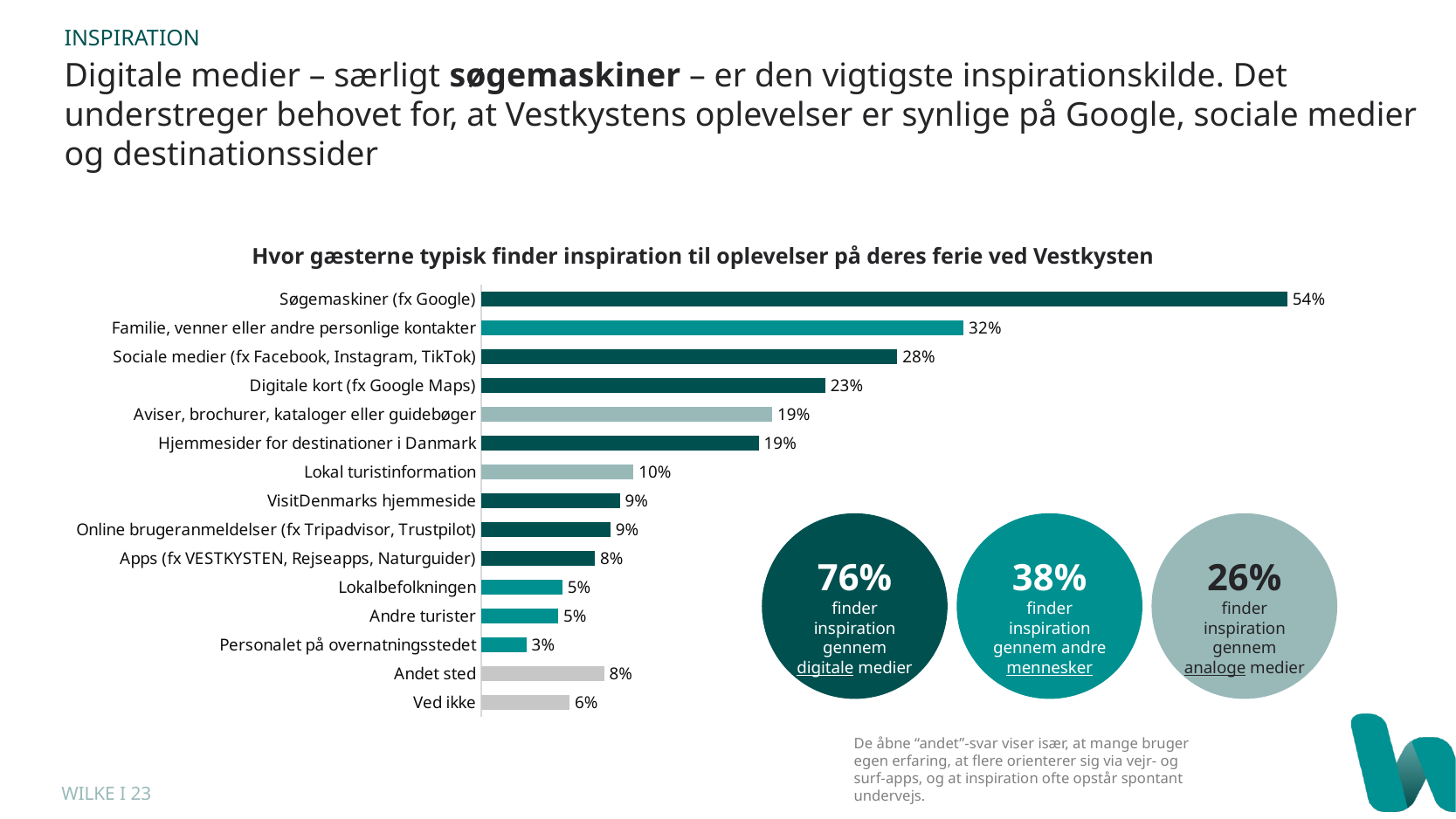
What type of chart is shown on the slide? Bar chart What is the value for Sociale medier (fx Facebook, Instagram, TikTok)? 28% What percentage of guests find inspiration through Søgemaskiner (fx Google)? 54% What is the value shown for Lokal turistinformation? 10% What is the value for Personalet på overnatningsstedet? 3% How many categories are shown in the bar chart? 15 What is the difference between Digitale kort (fx Google Maps) and Hjemmesider for destinationer i Danmark? 4 percentage points Which category has the lowest value in the chart? Personalet på overnatningsstedet Which is larger: Andet sted or Ved ikke? Andet sted Which category has the highest value in the chart? Søgemaskiner (fx Google) What is the difference between Søgemaskiner (fx Google) and Familie, venner eller andre personlige kontakter? 22 percentage points Which is larger: Familie, venner eller andre personlige kontakter or Sociale medier (fx Facebook, Instagram, TikTok)? Familie, venner eller andre personlige kontakter